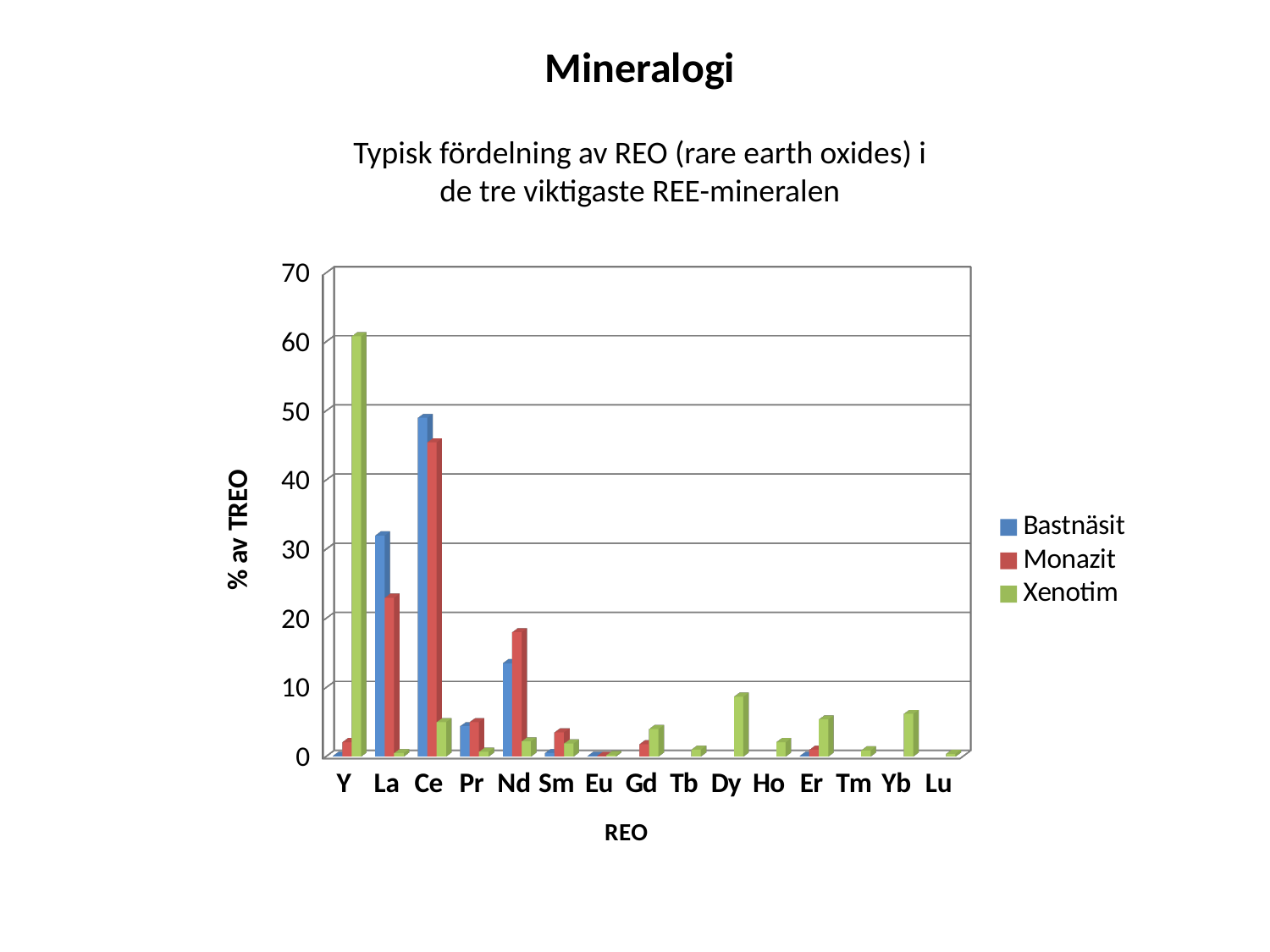
Which REO has the highest value for Bastnäsit? Ce Which REO has the highest value for Xenotim? Y For La, which is larger: Bastnäsit or Monazit? Bastnäsit Which REO has the highest value for Monazit? Ce How many REO categories are shown on the x axis? 15 What kind of chart is shown on the slide? bar chart For Nd, which is larger: Bastnäsit or Monazit? Monazit Is the Bastnäsit value for La greater or less than 30? greater How many series does the legend list? 3 Is the Monazit value for Nd greater or less than 20? less Is the Xenotim value for Y greater or less than 50? greater